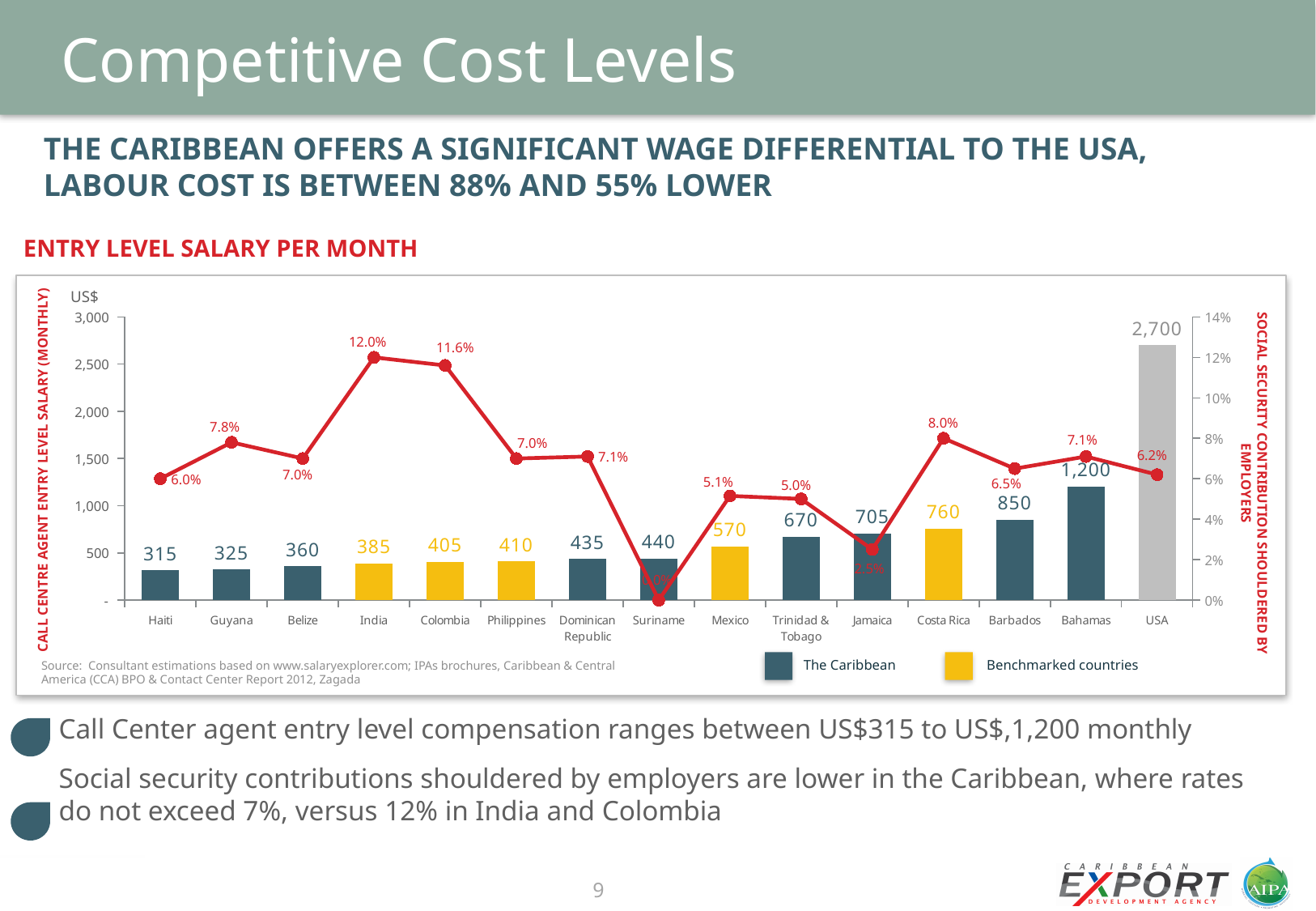
How many entries does the legend list? 2 What is the difference between the social security contribution rates for India and Haiti? 6.0% What is the entry level salary per month for Haiti? 315 Which country has the lowest entry level salary per month? Haiti Which country has the highest entry level salary per month? USA What social security contribution rate is shown for India? 12.0% Which has a higher entry level salary per month, Costa Rica or Jamaica? Costa Rica Which has a higher social security contribution rate, Colombia or Costa Rica? Colombia What colour are the bars for the benchmarked countries? Yellow What is the entry level salary per month for Bahamas? 1,200 How many countries are shown on the x axis of the chart? 15 What is the difference between the monthly salary for USA and Bahamas? 1,500